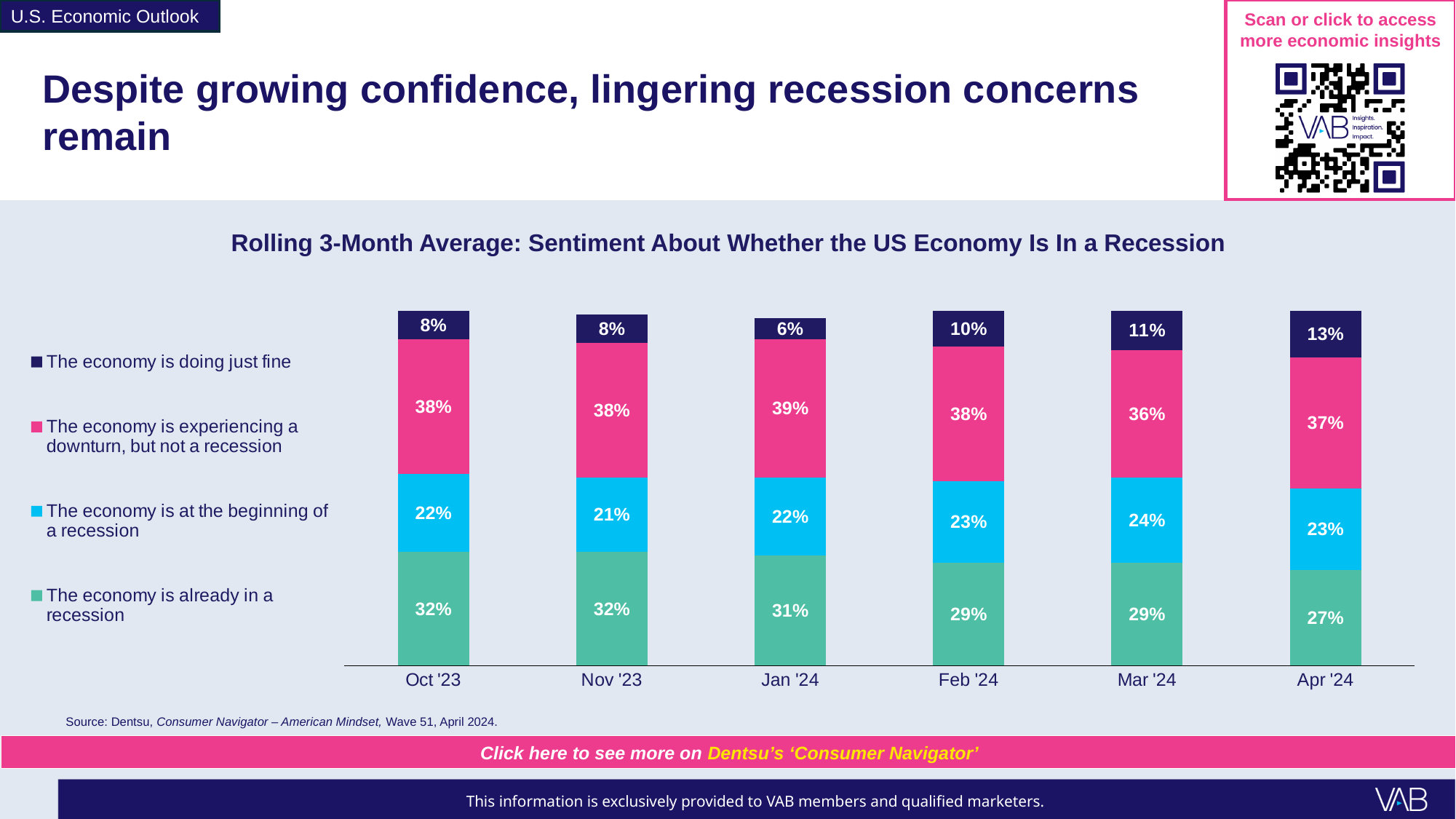
How many series does the legend list? 4 What percentage said the economy is at the beginning of a recession in Mar '24? 24% What percentage said the economy is already in a recession in Oct '23? 32% What percentage said the economy is experiencing a downturn, but not a recession in Jan '24? 39% In which month was the share saying the economy is already in a recession lowest? Apr '24 What percentage said the economy is doing just fine in Apr '24? 13% What kind of chart is shown? Stacked bar chart What is the difference between the share saying the economy is already in a recession in Oct '23 and in Apr '24? 5 percentage points Which is larger: the share saying the economy is doing just fine in Feb '24 or in Mar '24? Mar '24 Does the share saying the economy is doing just fine rise or fall from Jan '24 to Apr '24? Rise In which month was the share saying the economy is doing just fine lowest? Jan '24 How many months are shown on the x axis? 6